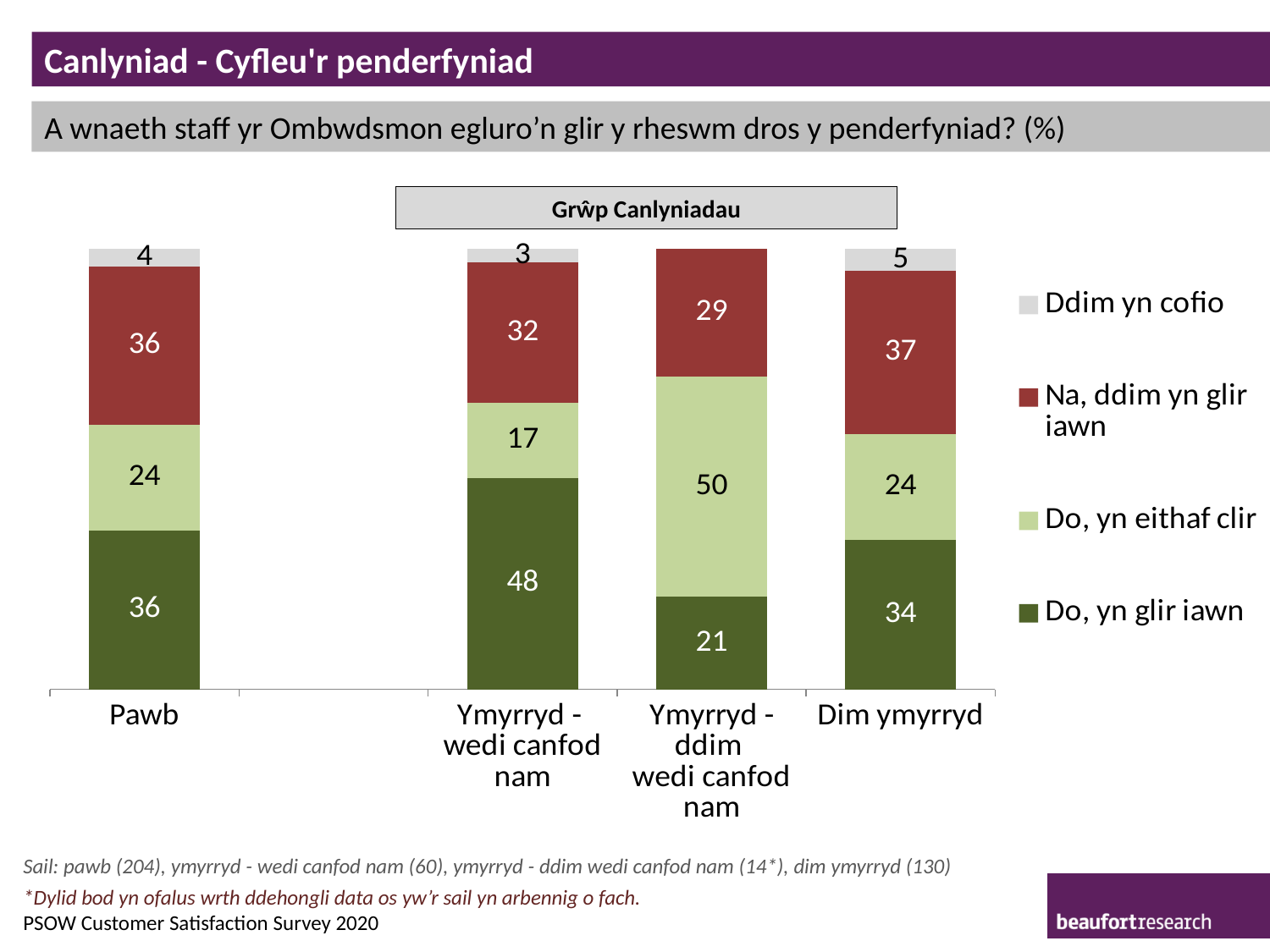
How many categories are shown along the x axis? 4 Which category has the lowest value for 'Do, yn glir iawn'? Ymyrryd - ddim wedi canfod nam Which is larger: the 'Do, yn eithaf clir' value for 'Pawb' or for 'Ymyrryd - wedi canfod nam'? Pawb How many series does the legend list? 4 What is the value for 'Do, yn glir iawn' in the 'Pawb' bar? 36 Which category has the highest value for 'Do, yn glir iawn'? Ymyrryd - wedi canfod nam What is the total of the stacked bar for 'Ymyrryd - wedi canfod nam'? 100 What is the label of the box above the three right-hand bars? Grŵp Canlyniadau What is the value for 'Do, yn eithaf clir' in the 'Ymyrryd - ddim wedi canfod nam' bar? 50 What kind of chart is shown on the slide? stacked bar chart What is the difference between the 'Na, ddim yn glir iawn' values for 'Dim ymyrryd' and 'Ymyrryd - wedi canfod nam'? 5 What is the value for 'Ddim yn cofio' in the 'Dim ymyrryd' bar? 5